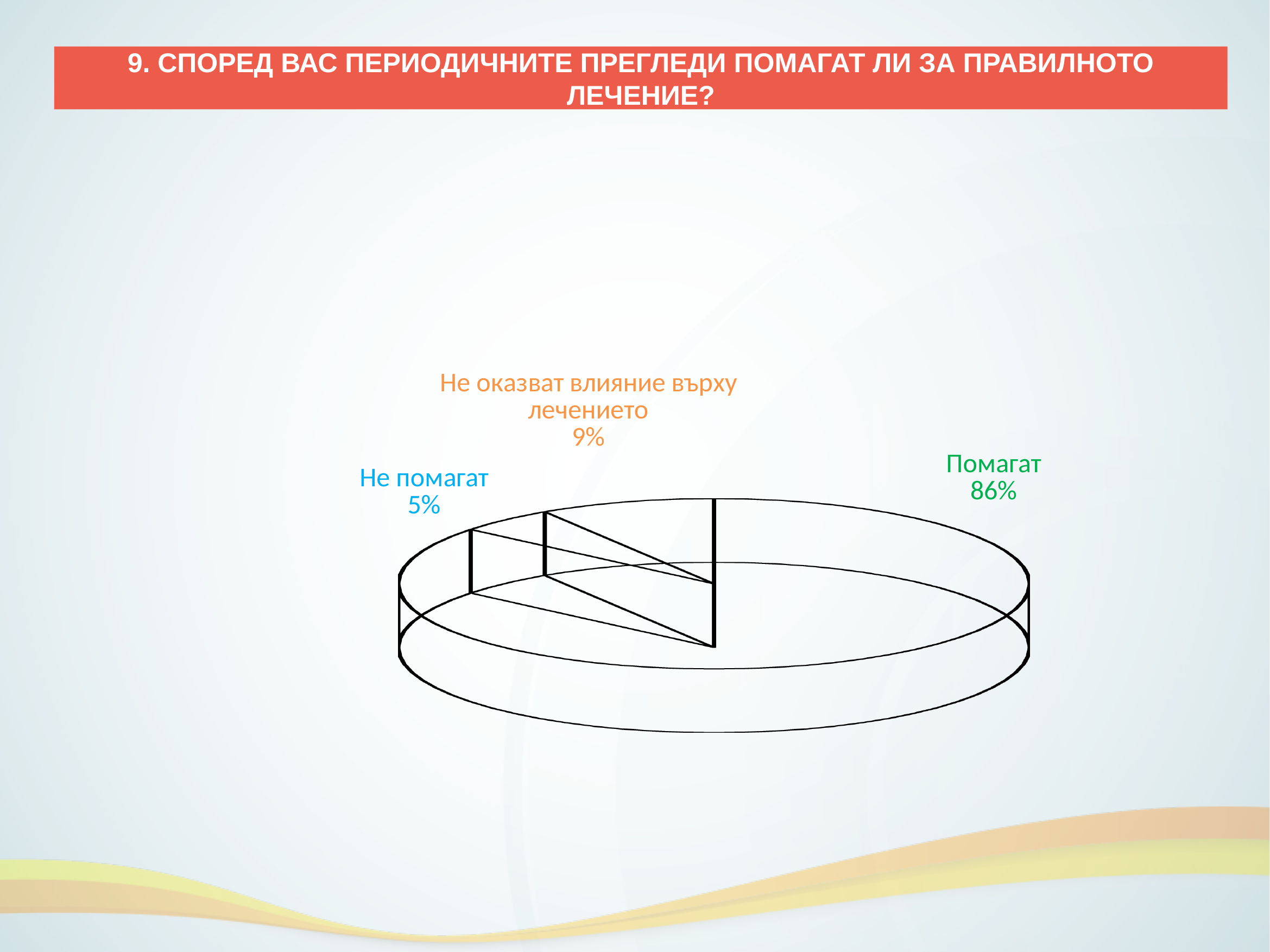
What is the difference in percentage points between "Не оказват влияние върху лечението" and "Не помагат"? 4 What is the title of the slide above the chart? 9. СПОРЕД ВАС ПЕРИОДИЧНИТЕ ПРЕГЛЕДИ ПОМАГАТ ЛИ ЗА ПРАВИЛНОТО ЛЕЧЕНИЕ? What is the difference in percentage points between "Помагат" and "Не оказват влияние върху лечението"? 77 What share of the pie does "Не помагат" have? 5% Which category has the smallest share of the pie? Не помагат Which category has the largest share of the pie? Помагат What kind of chart is shown on the slide? pie chart Which is larger, the share for "Не помагат" or the share for "Не оказват влияние върху лечението"? Не оказват влияние върху лечението What share of the pie does "Помагат" have? 86% What share of the pie does "Не оказват влияние върху лечението" have? 9% How many categories does the pie chart show? 3 In what colour is the label "Помагат 86%" written? green